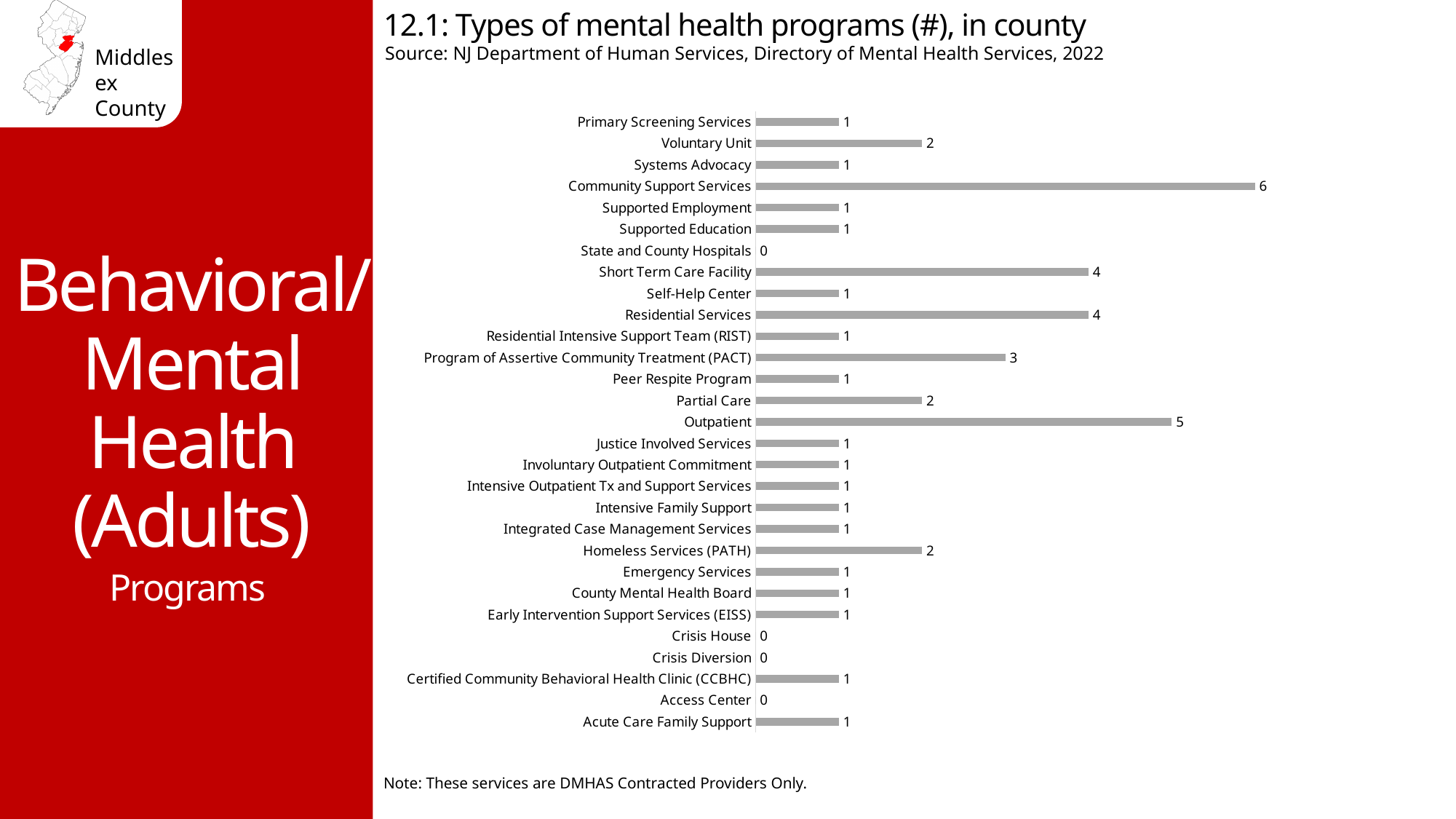
What kind of chart is shown on the slide? Bar chart What is the value for Program of Assertive Community Treatment (PACT)? 3 How many categories are shown in the chart? 29 What is the value for Crisis House? 0 What is the value for Outpatient? 5 How many categories have a value of 0? 4 Which is larger, the value for Short Term Care Facility or the value for Partial Care? Short Term Care Facility What is the title of the chart? 12.1: Types of mental health programs (#), in county What is the value for Community Support Services? 6 What is the value for Homeless Services (PATH)? 2 What is the difference between the values for Community Support Services and Outpatient? 1 Which category has the highest value? Community Support Services